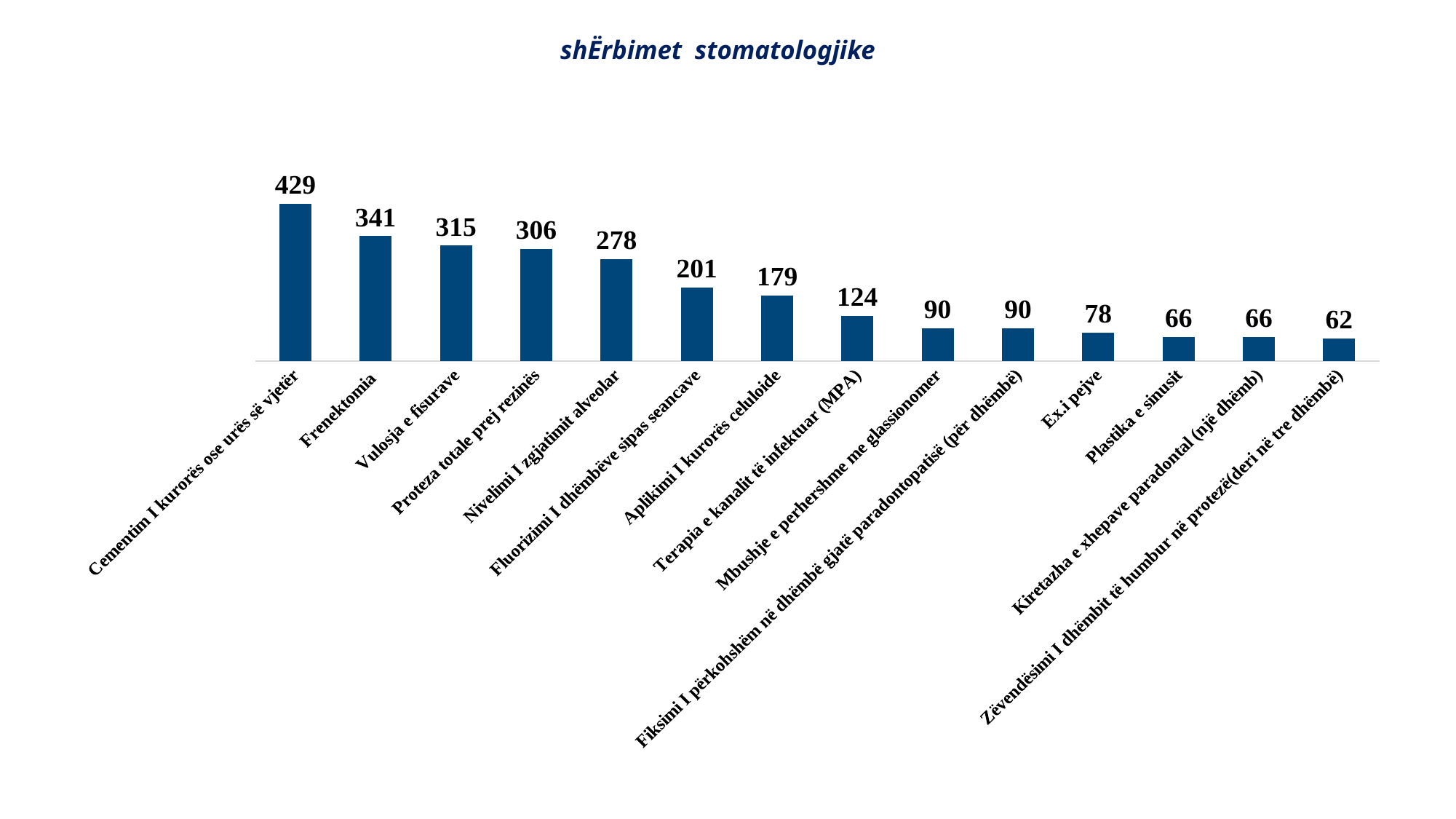
Which is larger, the value for Nivelimi I zgjatimit alveolar or the value for Fluorizimi I dhëmbëve sipas seancave? Nivelimi I zgjatimit alveolar What kind of chart is shown on the slide? Bar chart What is the value for Ex.i pejve? 78 Which category has the highest value? Cementim I kurorës ose urës së vjetër What is the difference between the values for Vulosja e fisurave and Proteza totale prej rezinës? 9 How many categories are shown in the chart? 14 What is the value for Terapia e kanalit të infektuar (MPA)? 124 What is the difference between the values for Cementim I kurorës ose urës së vjetër and Frenektomia? 88 What is the value for Frenektomia? 341 What is the title of the chart? shËrbimet stomatologjike Which category has the lowest value? Zëvendësimi I dhëmbit të humbur në protezë(deri në tre dhëmbë) Do the values rise or fall from left to right along the x axis? Fall